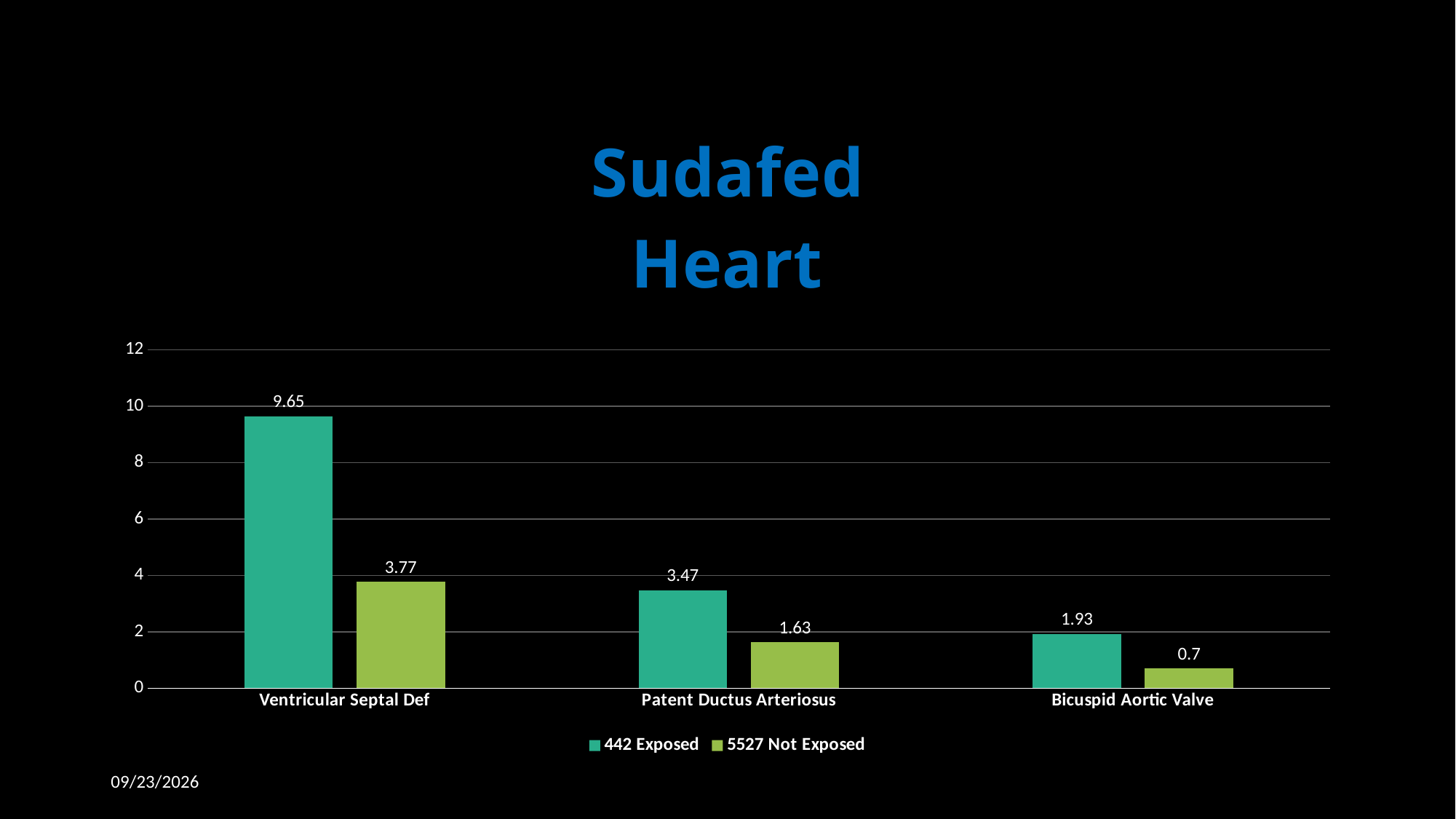
Which is larger: the 442 Exposed value for Patent Ductus Arteriosus or the 5527 Not Exposed value for Ventricular Septal Def? 5527 Not Exposed value for Ventricular Septal Def What kind of chart is shown on the slide? bar chart How many series does the legend list? 2 What is the value for 5527 Not Exposed in the Bicuspid Aortic Valve category? 0.7 Which category has the highest value for 442 Exposed? Ventricular Septal Def What is the value for 442 Exposed in the Ventricular Septal Def category? 9.65 What is the value for 5527 Not Exposed in the Patent Ductus Arteriosus category? 1.63 How many categories are shown on the x axis? 3 Is the 442 Exposed value for Ventricular Septal Def greater or less than 8? greater What is the difference between the 442 Exposed and 5527 Not Exposed values for Ventricular Septal Def? 5.88 Which category has the lowest value for 5527 Not Exposed? Bicuspid Aortic Valve What is the difference between the 442 Exposed values for Patent Ductus Arteriosus and Bicuspid Aortic Valve? 1.54